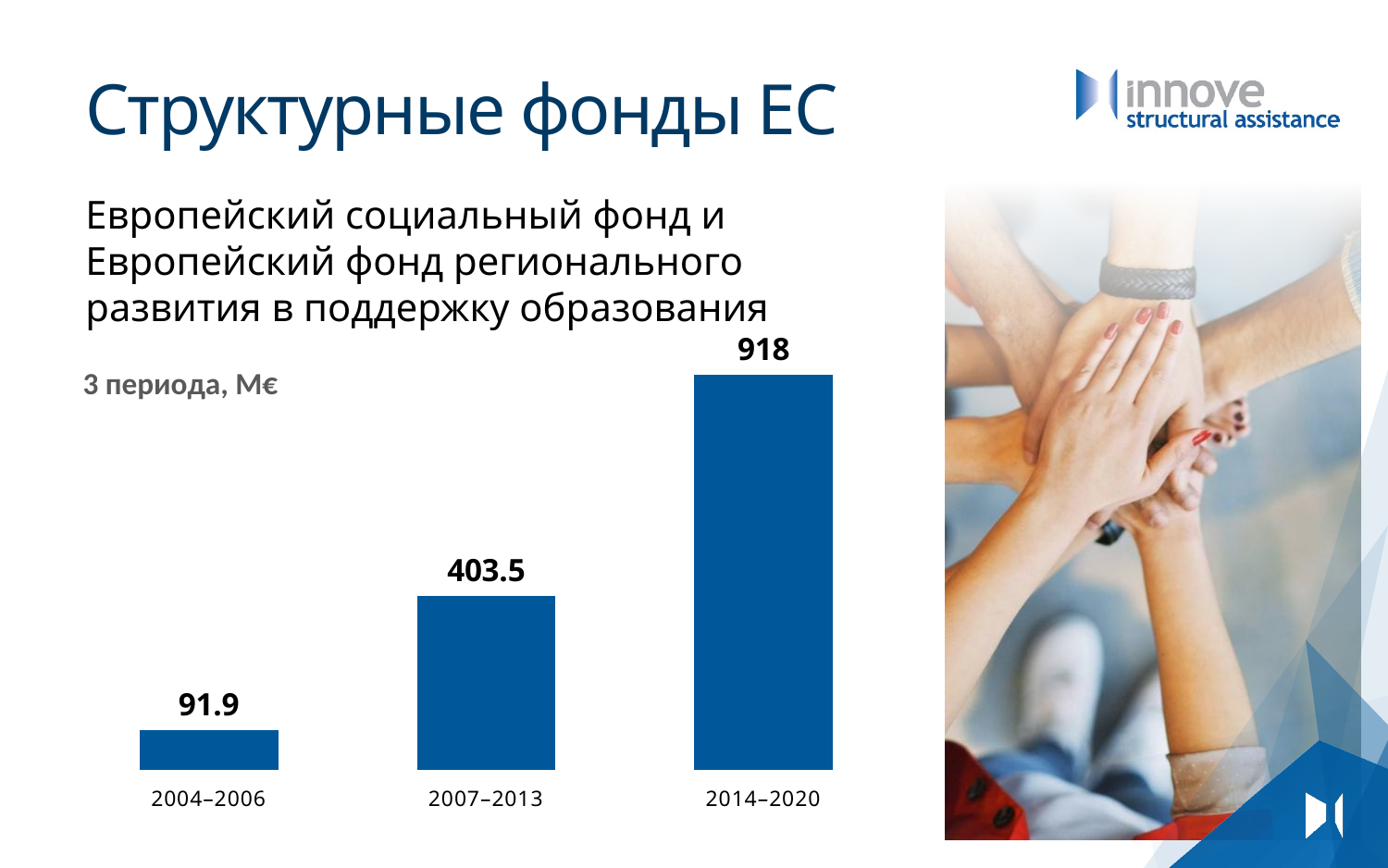
What is the value for the 2014–2020 period? 918 Which period has the highest value? 2014–2020 What is the difference between the values for 2007–2013 and 2004–2006? 311.6 What is the value for the 2007–2013 period? 403.5 How many periods are shown in the chart? 3 What unit is given in the chart's label above the bars? M€ Which is larger, the value for 2007–2013 or the value for 2004–2006? 2007–2013 What is the value for the 2004–2006 period? 91.9 Do the values rise or fall from the 2004–2006 period to the 2014–2020 period? Rise Which period has the lowest value? 2004–2006 What is the difference between the values for 2014–2020 and 2007–2013? 514.5 What kind of chart is shown on the slide? Bar chart